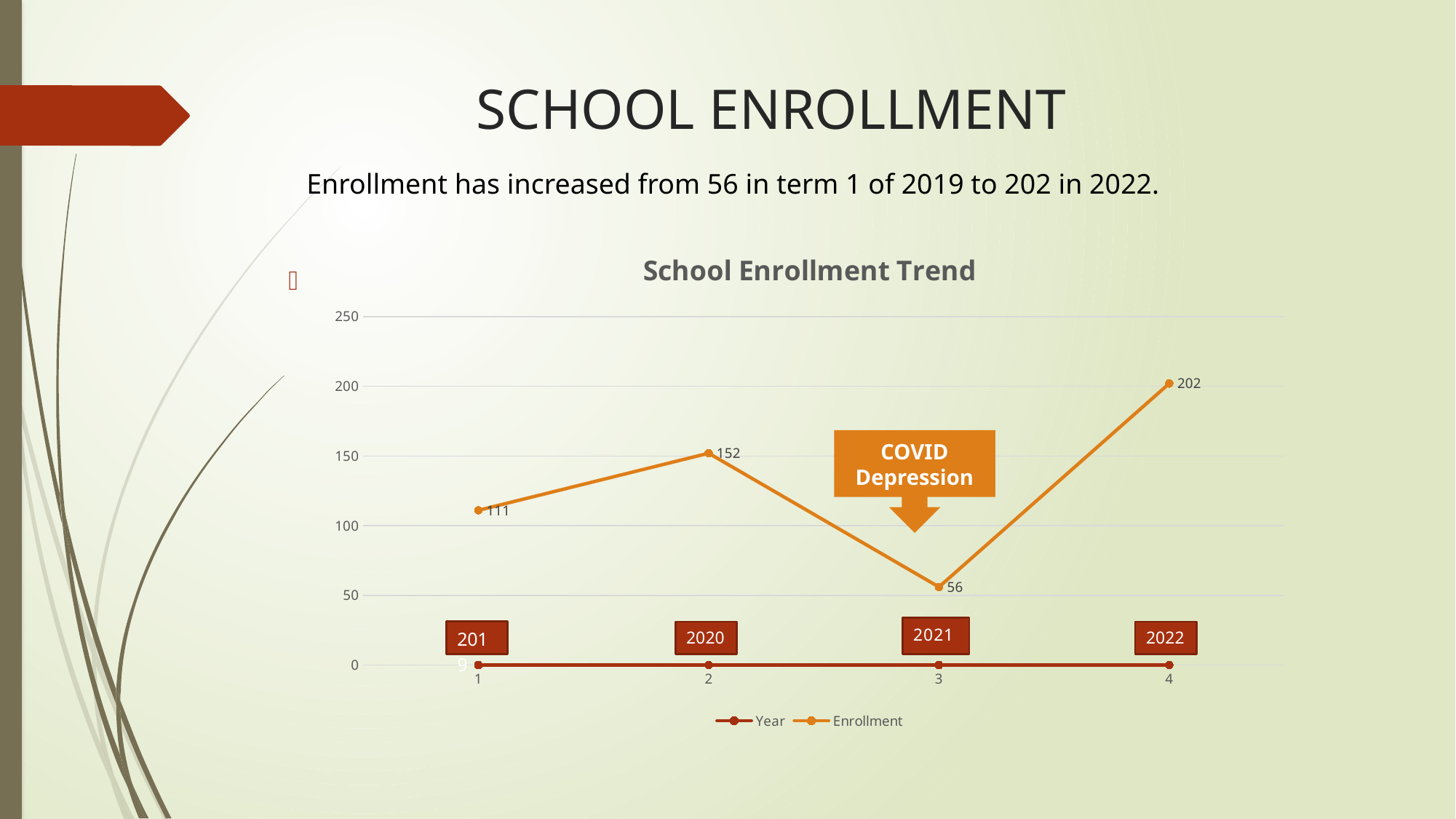
How many series does the legend list? 2 What type of chart is shown on the slide? line chart At which point is Enrollment highest? 4 (2022) What is the Enrollment value at point 2 (2020)? 152 What is the difference between the Enrollment values at point 4 (2022) and point 3 (2021)? 146 What is the Enrollment value at point 3 (2021)? 56 Which is larger, the Enrollment value at point 1 (2019) or at point 2 (2020)? point 2 (2020) Does Enrollment rise or fall from point 2 (2020) to point 3 (2021)? fall How many data points does the Enrollment series have? 4 What is the Enrollment value at point 1 (2019)? 111 At which point is Enrollment lowest? 3 (2021) What is the title of the chart? School Enrollment Trend